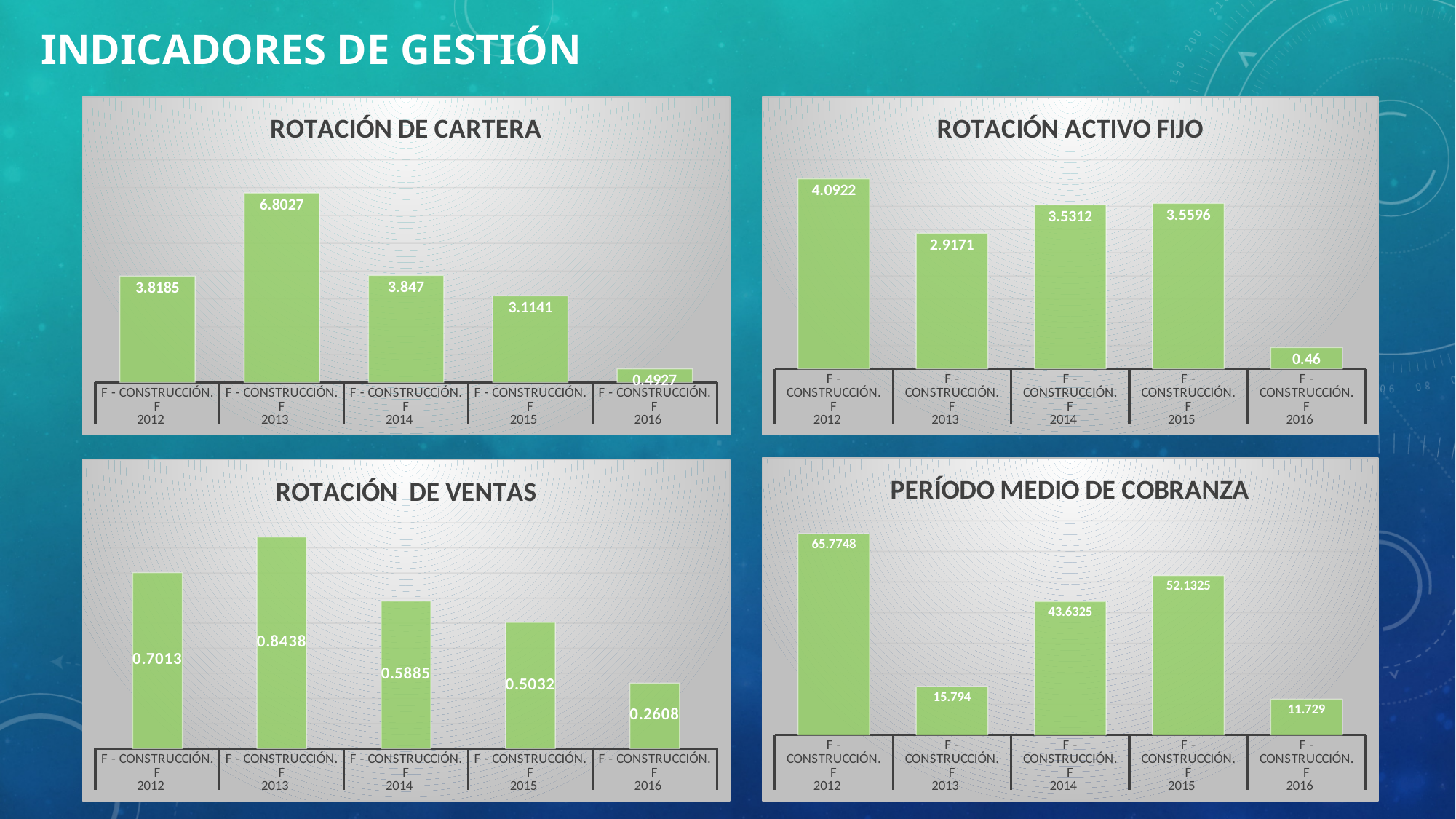
In the ROTACIÓN ACTIVO FIJO chart, what is the difference between the 2012 value and the 2013 value? 1.1751 In the ROTACIÓN ACTIVO FIJO chart, which year has the highest value? 2012 What kind of chart is the ROTACIÓN DE CARTERA chart? bar chart In the PERÍODO MEDIO DE COBRANZA chart, which year has the lowest value? 2016 In the ROTACIÓN ACTIVO FIJO chart, what is the value for 2016? 0.46 In the ROTACIÓN DE VENTAS chart, do the values rise or fall from 2013 to 2016? fall In the ROTACIÓN DE VENTAS chart, what is the value for 2014? 0.5885 How many bars does the PERÍODO MEDIO DE COBRANZA chart have? 5 In the ROTACIÓN DE CARTERA chart, what is the value for 2013? 6.8027 In the ROTACIÓN DE CARTERA chart, which year has the lowest value? 2016 In the PERÍODO MEDIO DE COBRANZA chart, what is the value for 2015? 52.1325 In the ROTACIÓN DE VENTAS chart, which is larger, the value for 2012 or the value for 2015? 2012